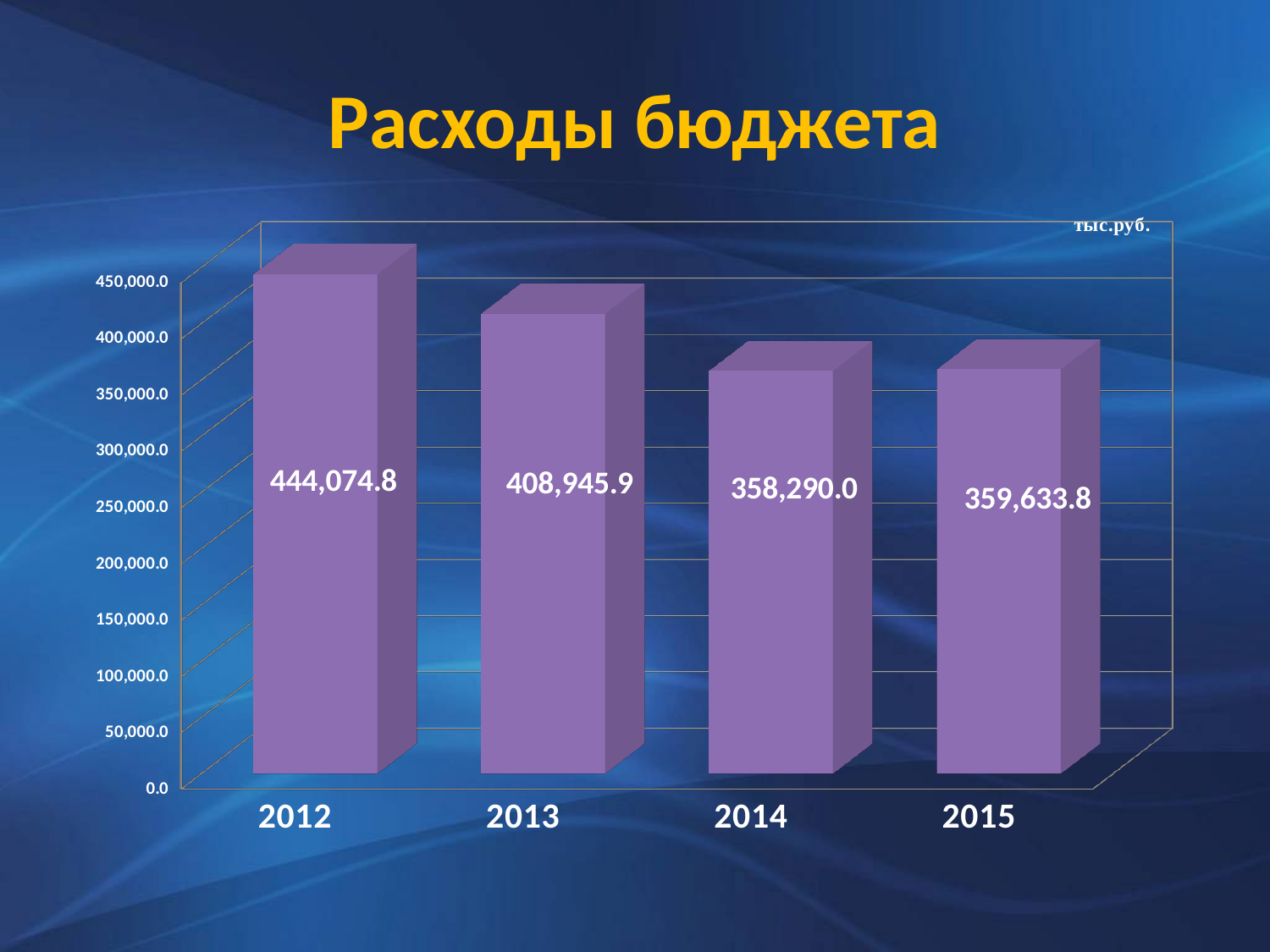
Which is larger, the value for 2014 or the value for 2015? 2015 Which year has the highest value? 2012 What is the value for 2013? 408,945.9 Which year has the lowest value? 2014 What is the title of the slide? Расходы бюджета How many years are shown on the chart? 4 What is the difference between the values for 2012 and 2013? 35,128.9 What is the value for 2015? 359,633.8 What is the value for 2012? 444,074.8 What is the value for 2014? 358,290.0 What is the difference between the values for 2015 and 2014? 1,343.8 What kind of chart is shown on the slide? Bar chart